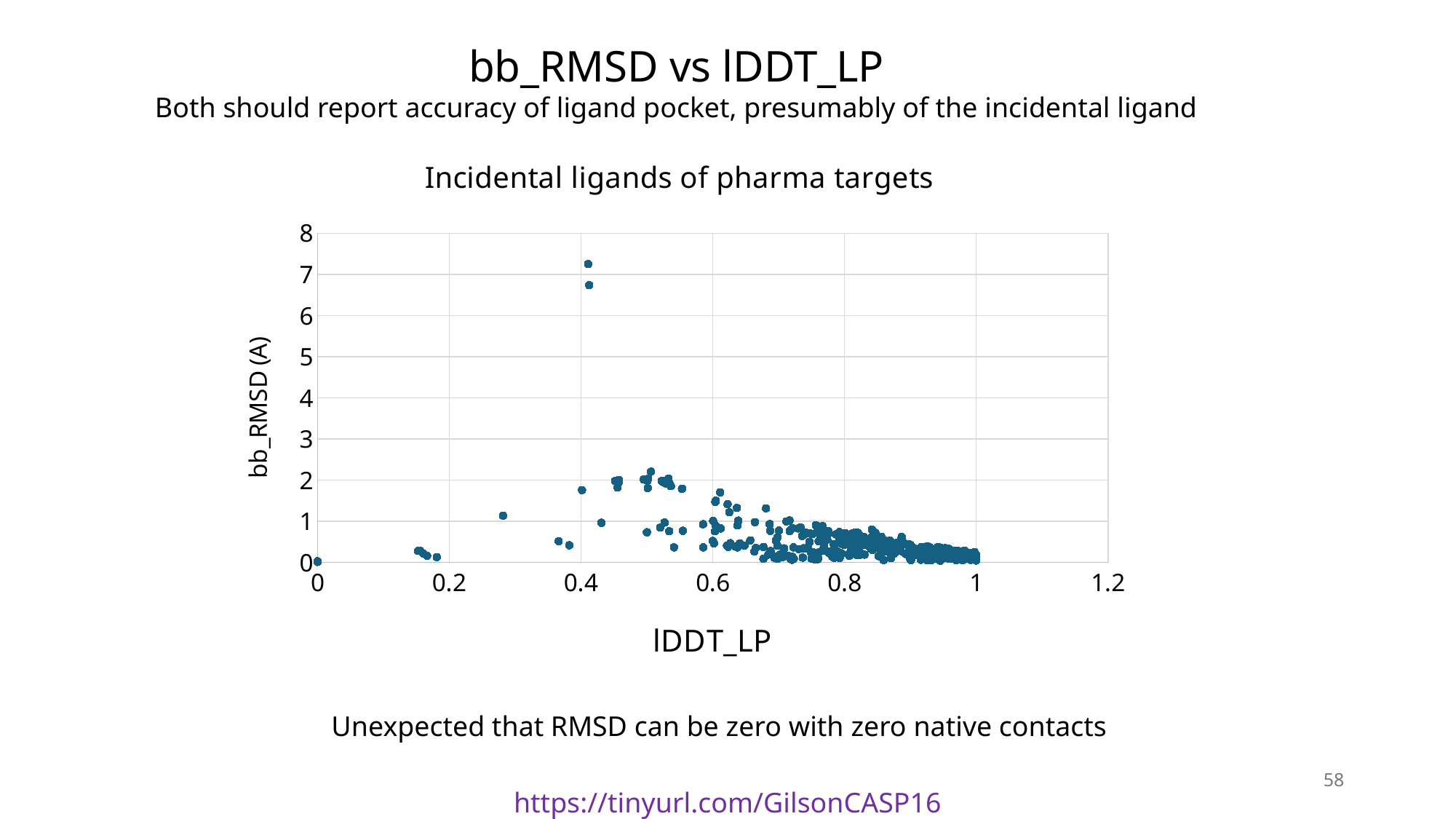
Is the bb_RMSD of the isolated point near lDDT_LP = 0.28 greater or less than 2? less Are any points plotted with lDDT_LP greater than 1? No Is the highest bb_RMSD value plotted greater or less than 6? greater Which has the larger bb_RMSD: the points near lDDT_LP = 0.4 at the top of the chart, or the points near lDDT_LP = 1? The points near lDDT_LP = 0.4 What is the label of the y axis of the chart? bb_RMSD (A) What kind of chart is shown on the slide? Scatter plot In which lDDT_LP range are most of the points clustered: 0 to 0.2 or 0.8 to 1? 0.8 to 1 What is the maximum value shown on the y axis? 8 What is the title of the chart? Incidental ligands of pharma targets For lDDT_LP values above 0.5, do bb_RMSD values generally rise or fall as lDDT_LP increases? fall